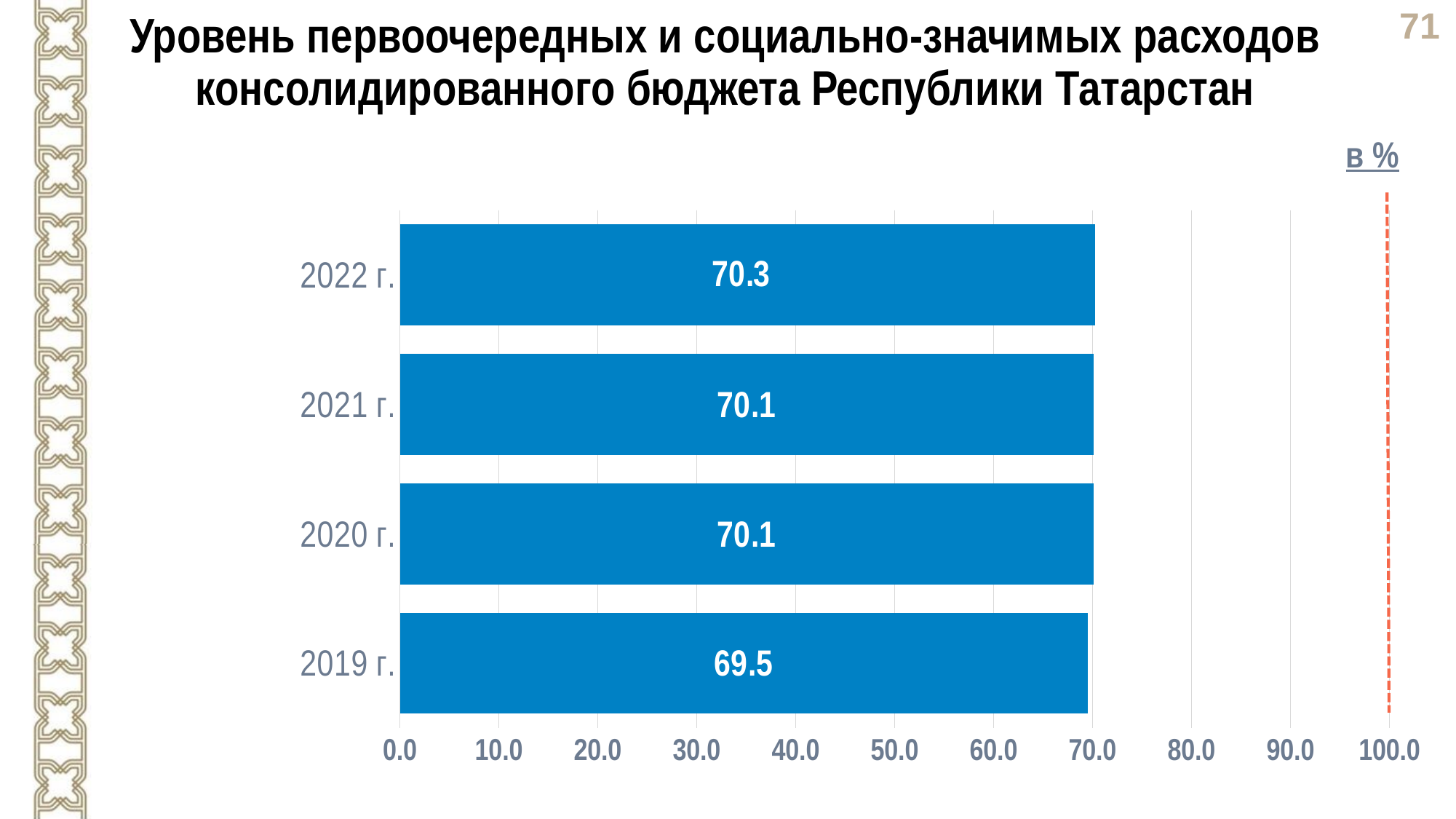
What unit is indicated for the values in the chart? в % Which year has the lowest value? 2019 г. Is the value for 2020 г. greater or less than 60.0? greater Is the value for 2022 г. greater or less than 80.0? less What kind of chart is shown on the slide? bar chart What is the value for 2021 г.? 70.1 What is the difference between the values for 2022 г. and 2019 г.? 0.8 Which year has the highest value? 2022 г. How many years are shown in the chart? 4 What is the value for 2022 г.? 70.3 What is the difference between the values for 2021 г. and 2020 г.? 0.0 What is the value for 2019 г.? 69.5